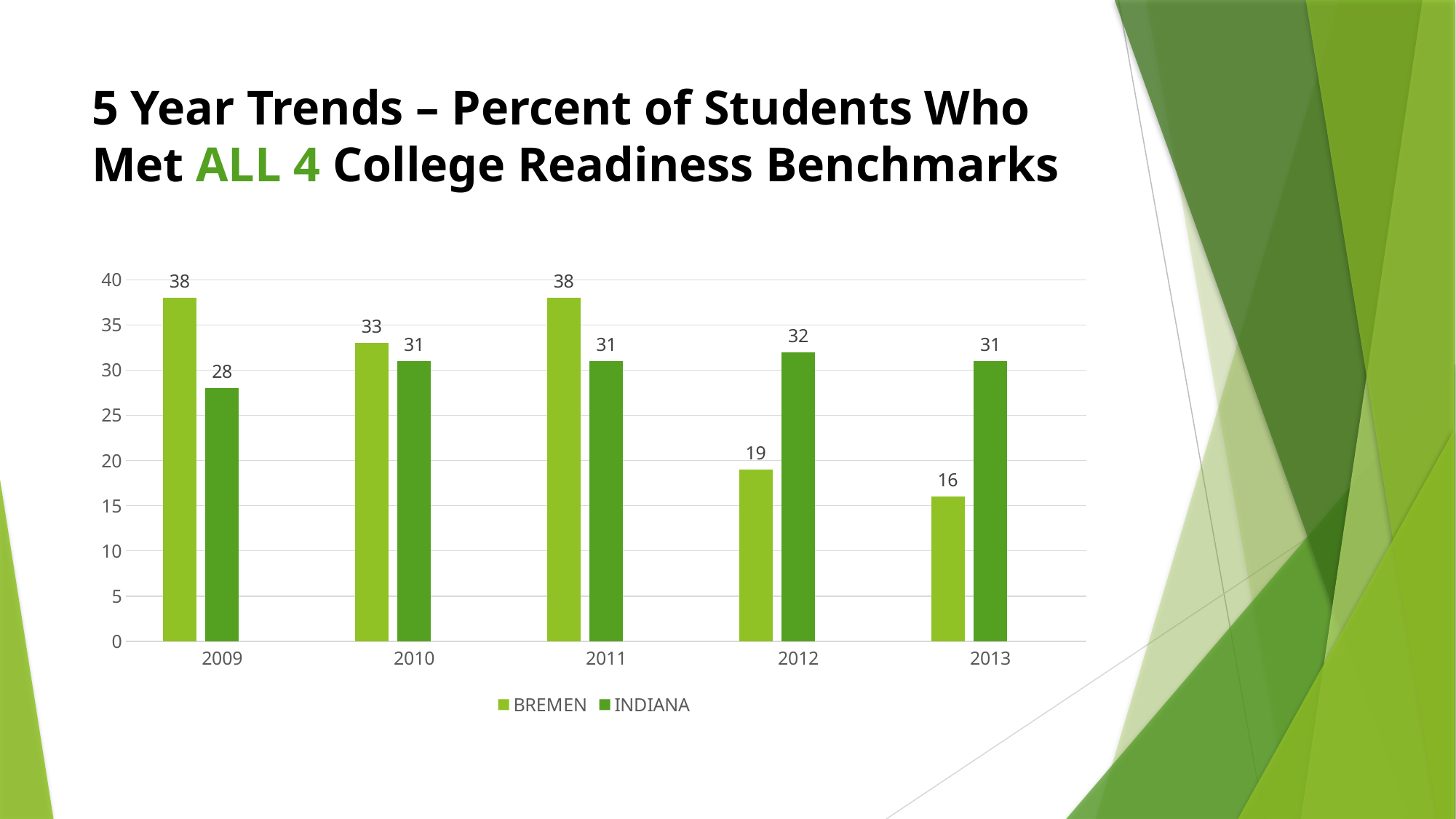
What is the value for INDIANA in 2012? 32 Does the BREMEN value rise or fall from 2011 to 2013? fall How many series does the legend list? 2 What is the value for BREMEN in 2013? 16 In which year is the INDIANA value lowest? 2009 What is the value for BREMEN in 2009? 38 What kind of chart is shown on the slide? bar chart Is the value for BREMEN in 2010 greater or less than 30? greater In which year is the BREMEN value lowest? 2013 What is the difference between the BREMEN and INDIANA values in 2011? 7 How many years are shown on the x axis? 5 Which is larger in 2012, the BREMEN value or the INDIANA value? INDIANA